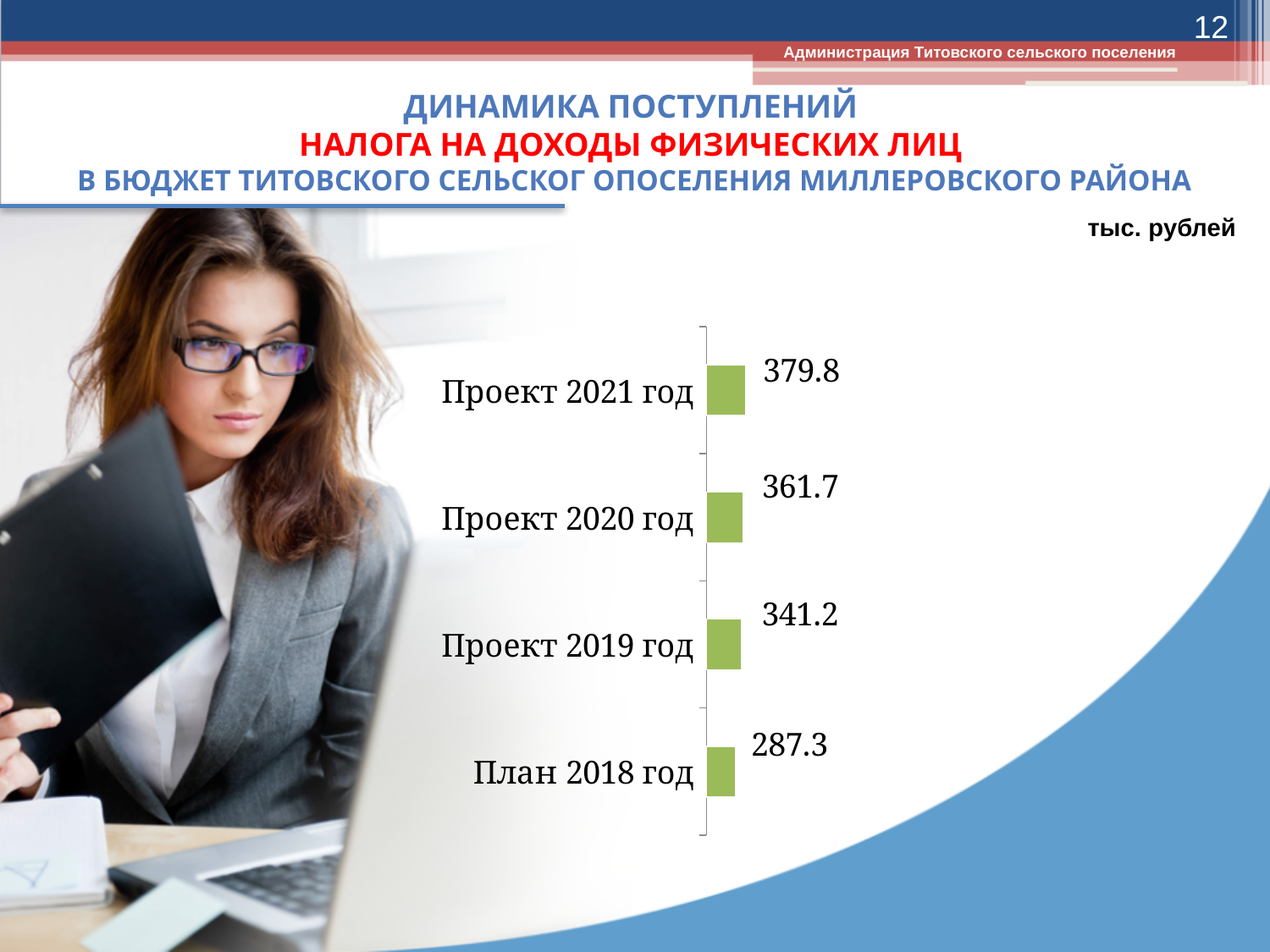
Which category has the highest value? Проект 2021 год What is the value for Проект 2020 год? 361.7 How many categories are shown in the chart? 4 What is the value for Проект 2019 год? 341.2 What is the difference between the values for Проект 2021 год and Проект 2020 год? 18.1 What is the difference between the values for Проект 2019 год and План 2018 год? 53.9 Which category has the lowest value? План 2018 год What kind of chart is shown on the slide? Bar chart What is the value for Проект 2021 год? 379.8 Which is larger, the value for Проект 2020 год or Проект 2019 год? Проект 2020 год What is the value for План 2018 год? 287.3 In what units are the chart values given, according to the slide? тыс. рублей